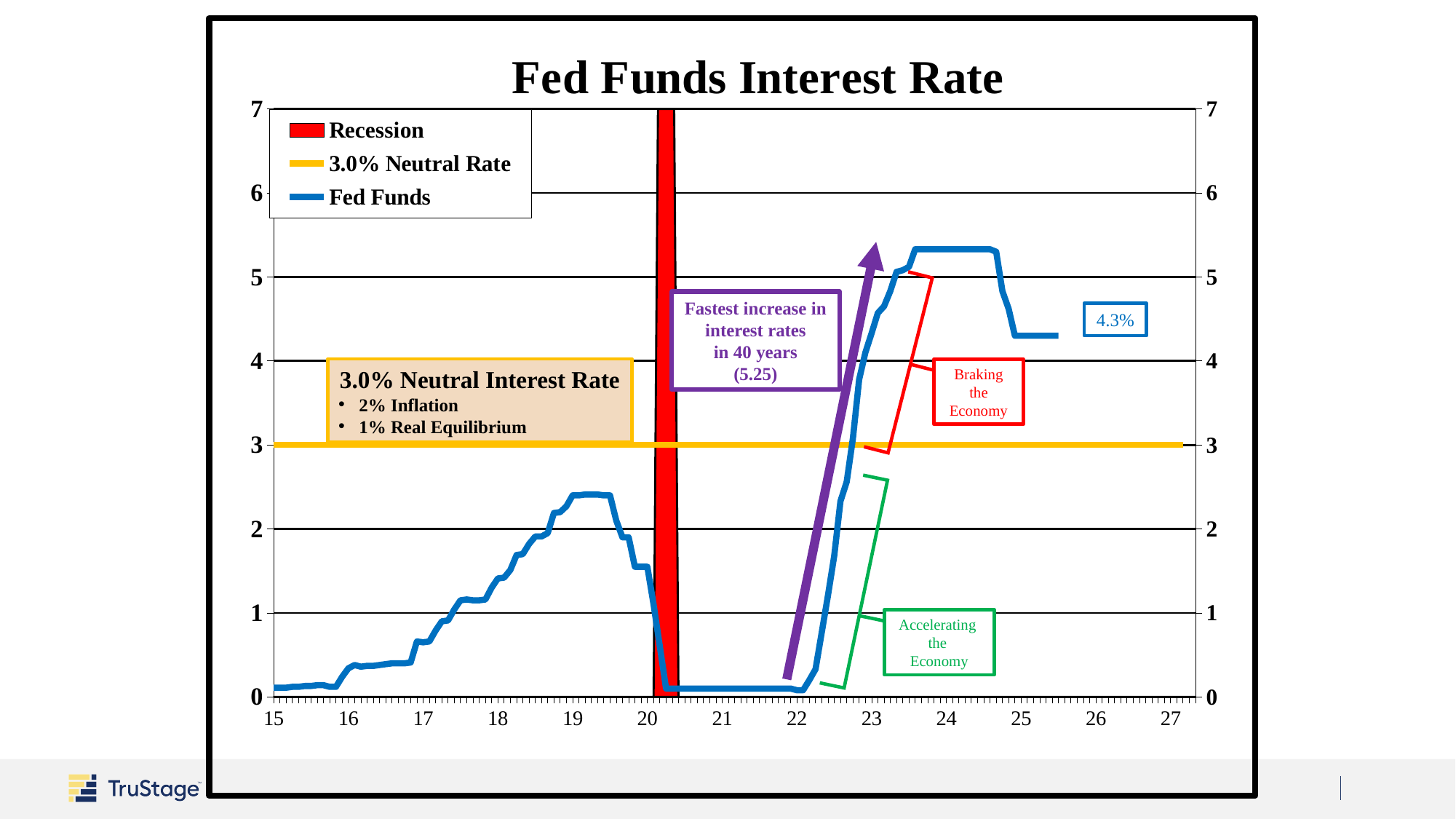
Is the Fed Funds rate in 2021 greater or less than 1? less How many entries does the chart legend list? 3 Which is higher, the Fed Funds rate in 2024 or the Fed Funds rate in 2019? 2024 What is the labeled value of the Fed Funds rate at the end of the line? 4.3% What type of chart is shown on the slide? Line chart What value is the neutral rate line drawn at? 3.0% Does the Fed Funds rate rise or fall between 2022 and 2023? rise What is the difference between the final labeled Fed Funds rate (4.3%) and the 3.0% neutral rate? 1.3% According to the annotation, what was the peak of the fastest increase in interest rates in 40 years? 5.25 Is the Fed Funds rate at the start of 2019 greater or less than 2? greater What is the title of the chart? Fed Funds Interest Rate Is the Fed Funds rate in 2024 greater or less than 5? greater